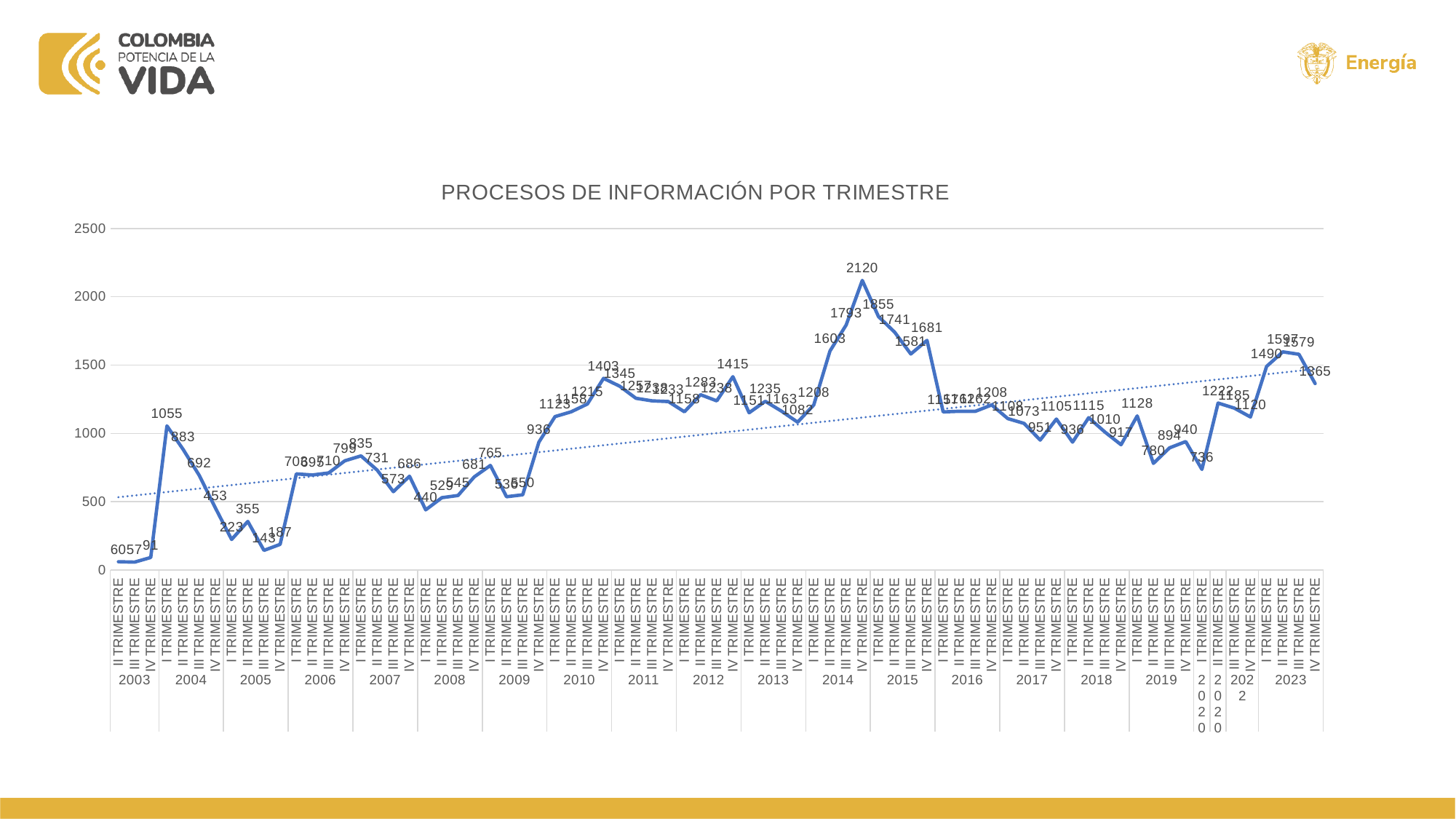
What is the value for IV TRIMESTRE 2023? 1365 What is the difference between the value for IV TRIMESTRE 2014 and the value for I TRIMESTRE 2015? 265 What is the value for I TRIMESTRE 2005? 223 What kind of chart is shown on the slide? line chart What is the value for IV TRIMESTRE 2012? 1415 Which is larger, the value for I TRIMESTRE 2004 or the value for IV TRIMESTRE 2010? IV TRIMESTRE 2010 Which quarter has the highest value on the chart? IV TRIMESTRE 2014 What is the title of the chart? PROCESOS DE INFORMACIÓN POR TRIMESTRE What is the lowest value plotted on the chart? 57 What is the highest value plotted on the chart? 2120 Is the value for IV TRIMESTRE 2014 greater or less than 2000? greater What is the value for I TRIMESTRE 2004? 1055